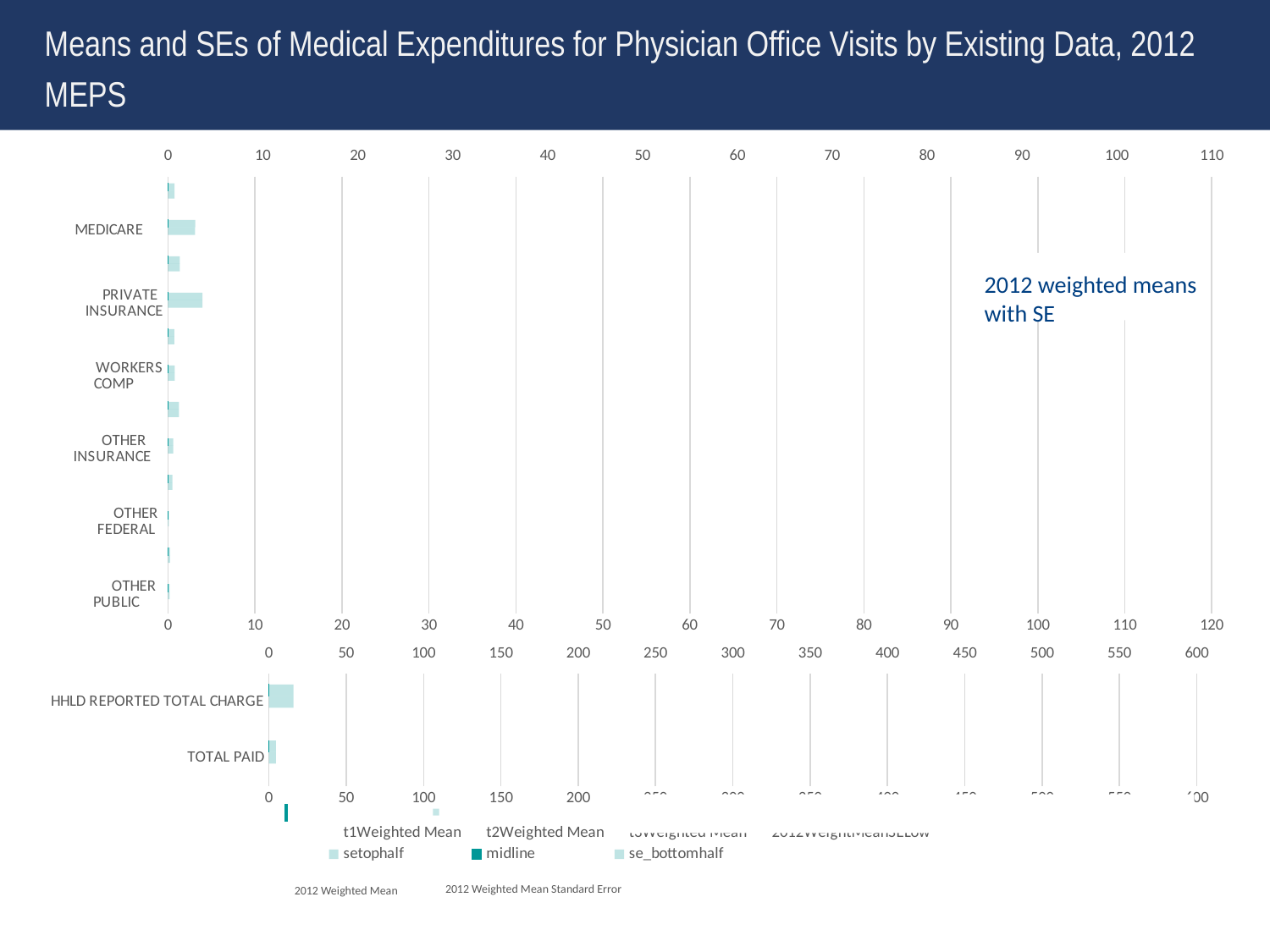
What is the highest tick value shown on the top axis of the bottom chart? 600 In the bottom chart, which has the larger value, HHLD REPORTED TOTAL CHARGE or TOTAL PAID? HHLD REPORTED TOTAL CHARGE What is the title of the slide containing the charts? Means and SEs of Medical Expenditures for Physician Office Visits by Existing Data, 2012 MEPS What kind of chart is the top chart on the slide? bar chart How many categories are labelled on the vertical axis of the bottom chart? 2 In the top chart, which has the larger value, PRIVATE INSURANCE or OTHER PUBLIC? PRIVATE INSURANCE How many categories are labelled on the vertical axis of the top chart? 6 In the top chart, which has the larger value, MEDICARE or OTHER FEDERAL? MEDICARE